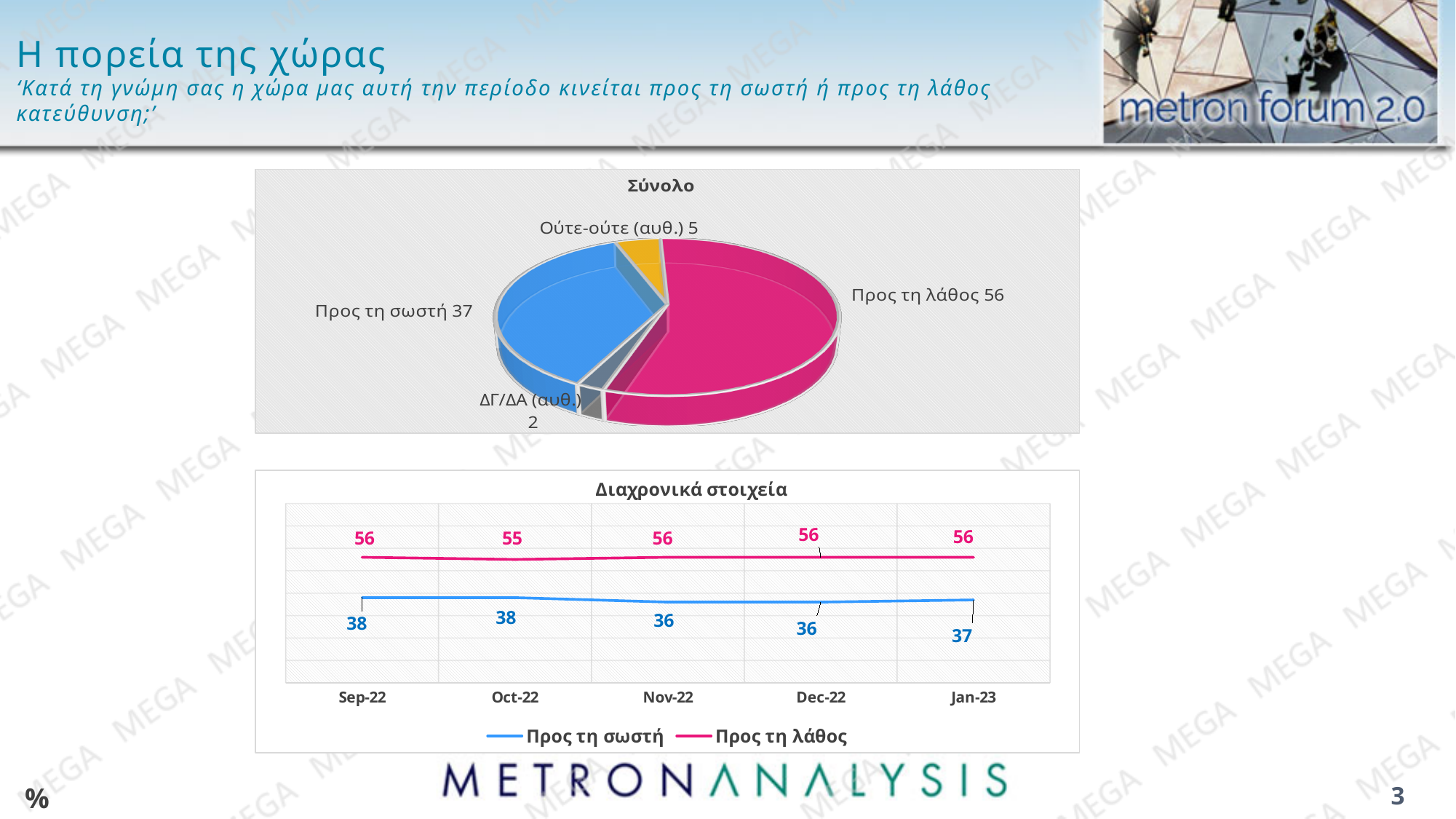
In the 'Σύνολο' pie chart, what is the difference between 'Προς τη λάθος' and 'Προς τη σωστή'? 19 How many slices does the 'Σύνολο' pie chart have? 4 What kind of chart is the 'Διαχρονικά στοιχεία' chart? Line chart In the 'Διαχρονικά στοιχεία' chart, how many time points are shown on the x axis? 5 In the 'Διαχρονικά στοιχεία' chart, what is the value for 'Προς τη σωστή' in Nov-22? 36 In the 'Σύνολο' pie chart, what is the value for 'Ούτε-ούτε (αυθ.)'? 5 In the 'Διαχρονικά στοιχεία' chart, what is the difference between 'Προς τη λάθος' and 'Προς τη σωστή' in Jan-23? 19 How many series does the legend of the 'Διαχρονικά στοιχεία' chart list? 2 In the 'Σύνολο' pie chart, which category has the largest slice? Προς τη λάθος In the 'Διαχρονικά στοιχεία' chart, what is the value for 'Προς τη λάθος' in Oct-22? 55 In the 'Σύνολο' pie chart, what is the value for 'Προς τη λάθος'? 56 In the 'Σύνολο' pie chart, which category has the smallest slice? ΔΓ/ΔΑ (αυθ.)